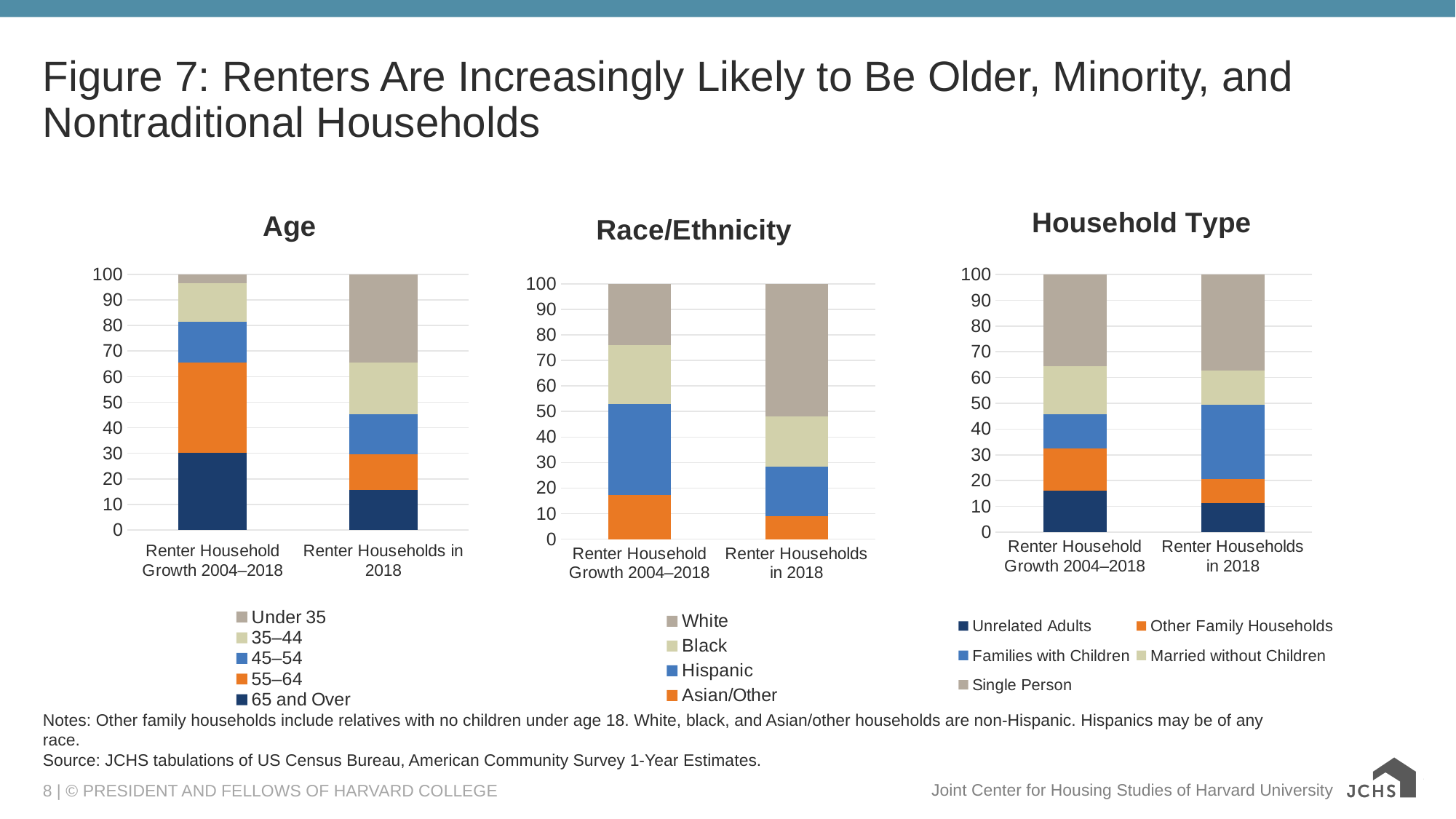
How many series does the legend of the Age chart list? 5 In the Age chart, what is the total of the stacked bar for Renter Households in 2018? 100 How many series does the legend of the Household Type chart list? 5 How many bars are plotted in the Race/Ethnicity chart? 2 In the Age chart, is the Under 35 segment larger for Renter Household Growth 2004–2018 or for Renter Households in 2018? Renter Households in 2018 How many series does the legend of the Race/Ethnicity chart list? 4 In the Race/Ethnicity chart, is the White segment for Renter Households in 2018 greater or less than 40? greater What is the title of the middle chart on the slide? Race/Ethnicity In the Age chart, is the 65 and Over segment for Renter Household Growth 2004–2018 greater or less than 20? greater In the Household Type chart, is the Single Person segment for Renter Households in 2018 greater or less than 30? greater In the Race/Ethnicity chart, is the Hispanic segment larger for Renter Household Growth 2004–2018 or for Renter Households in 2018? Renter Household Growth 2004–2018 What kind of chart is the Age chart? Stacked bar chart